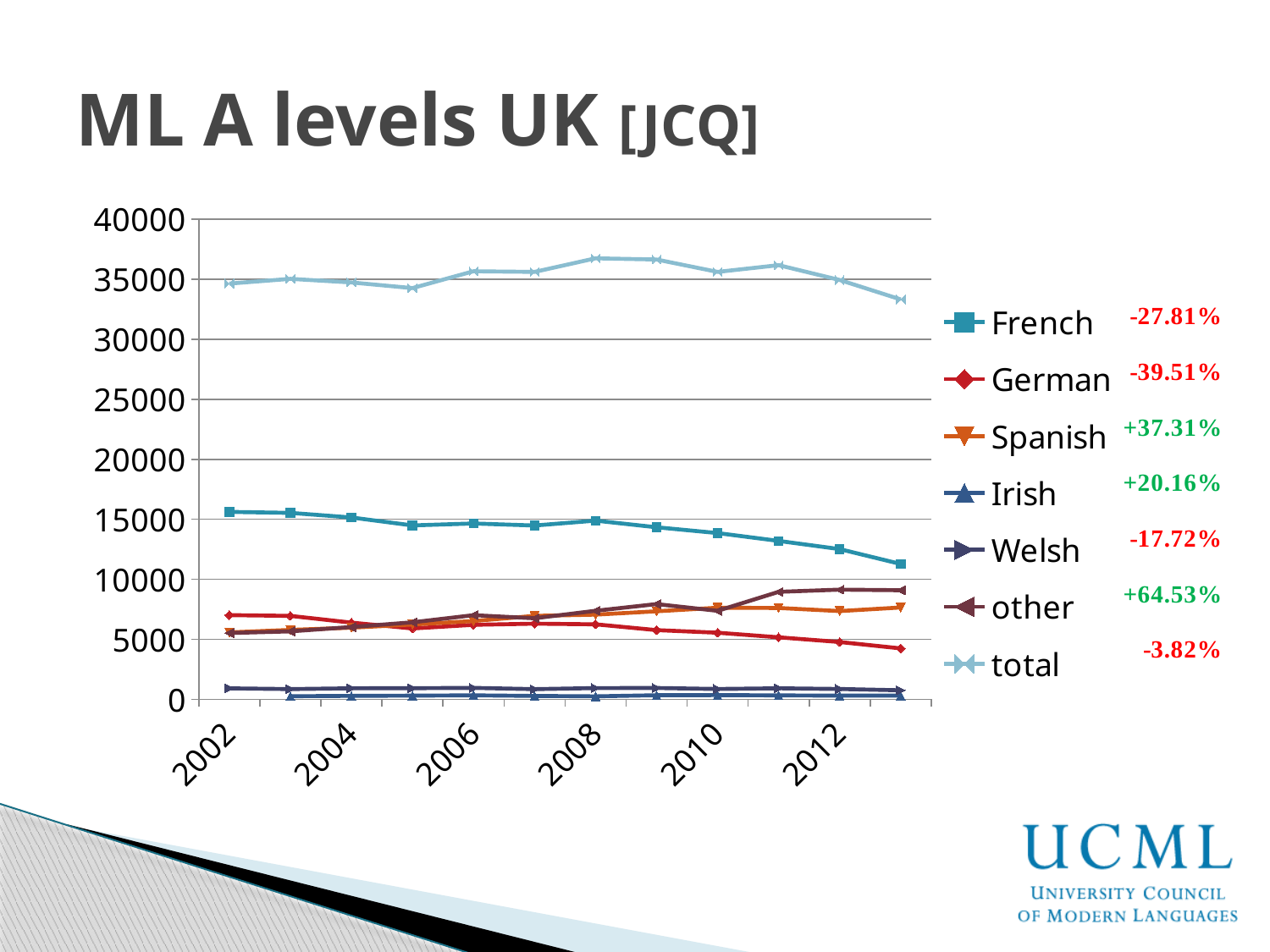
Is the value for total in 2008 greater or less than 35000? greater Is the value for French in 2013 greater or less than 15000? less Excluding the total line, which language series has the highest values throughout the chart? French Is the value for German in 2013 greater or less than 5000? less Does the Spanish line rise or fall from 2002 to 2013? rise Which series has the highest values across the whole chart? total In 2012, which is larger, other or Spanish? other What percentage change is printed next to the 'other' legend entry? +64.53% What kind of chart is shown on the slide? line chart In 2013, which is larger, Spanish or German? Spanish Does the French line rise or fall from 2002 to 2013? fall How many series does the legend list? 7